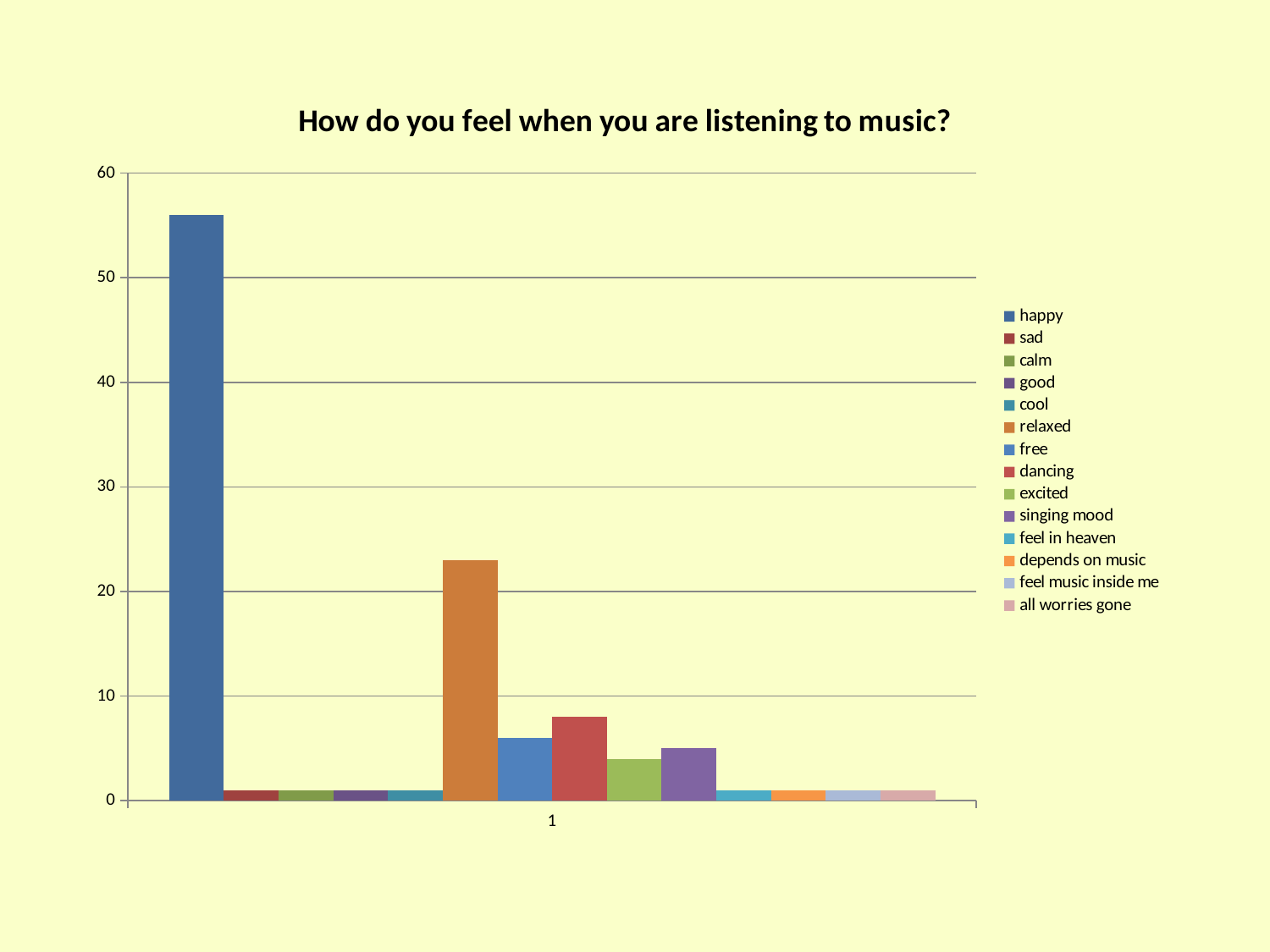
Which is larger, the value for happy or the value for relaxed? happy Which series has the second-highest value? relaxed Is the value for dancing greater or less than 10? less Which series has the highest value? happy What is the title of the chart? How do you feel when you are listening to music? Is the value for relaxed greater or less than 20? greater Which is larger, the value for dancing or the value for excited? dancing What kind of chart is shown on the slide? bar chart Which is larger, the value for relaxed or the value for dancing? relaxed Is the value for happy greater or less than 50? greater How many series does the legend list? 14